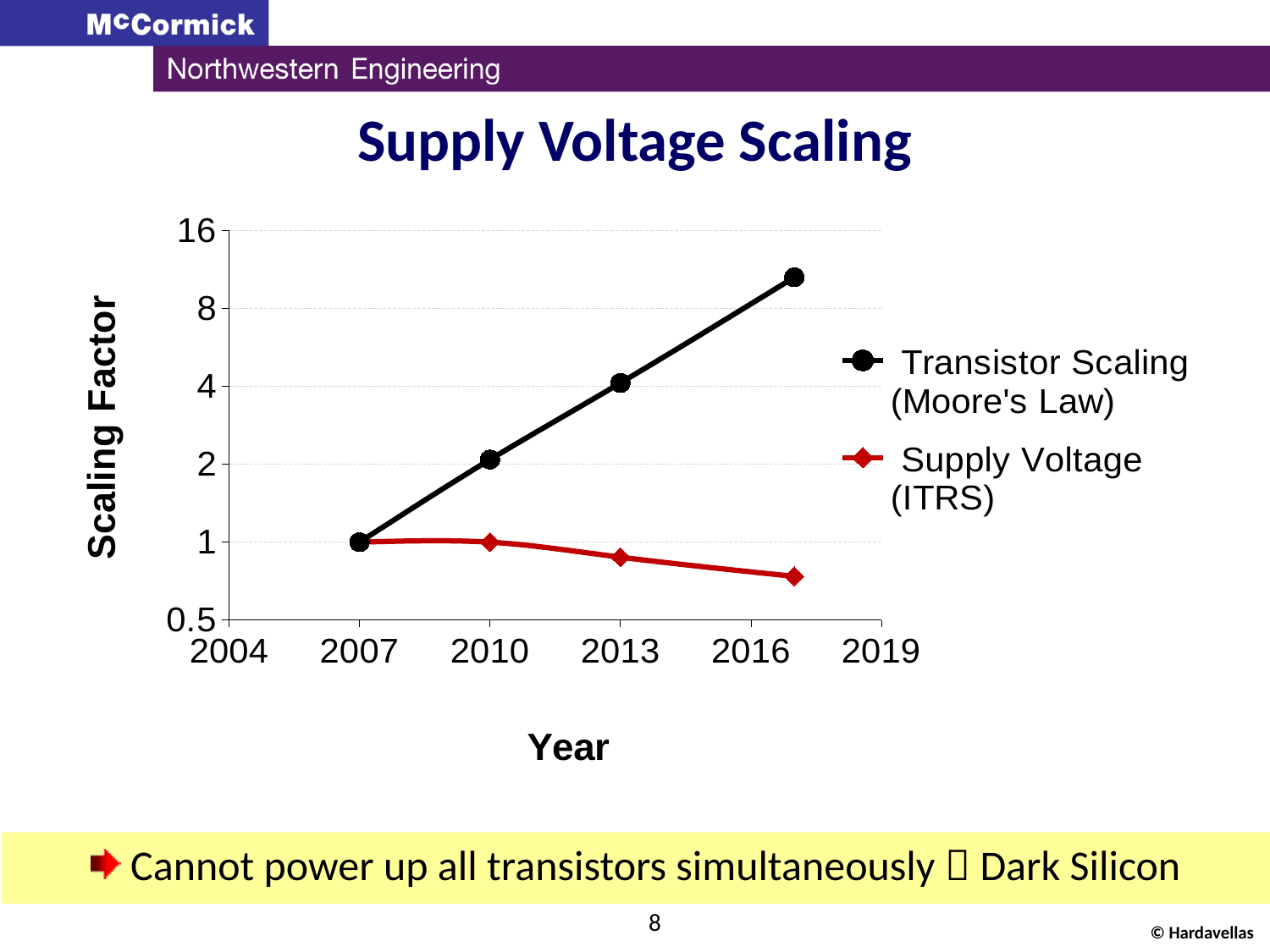
How many series does the legend list? 2 What are the two series named in the legend? Transistor Scaling (Moore's Law) and Supply Voltage (ITRS) Does the Supply Voltage (ITRS) series rise or fall from 2010 to 2017? fall How many data points are plotted for each series? 4 Does the Transistor Scaling (Moore's Law) series rise or fall from 2007 to 2017? rise Is the Supply Voltage (ITRS) value in 2017 greater or less than 1? less What is the Transistor Scaling (Moore's Law) value in 2007? 1 Is the Transistor Scaling (Moore's Law) value in 2017 greater or less than 8? greater What is the Supply Voltage (ITRS) value in 2010? 1 In 2017, which series has the higher scaling factor, Transistor Scaling (Moore's Law) or Supply Voltage (ITRS)? Transistor Scaling (Moore's Law) What kind of chart is shown on the slide? line chart